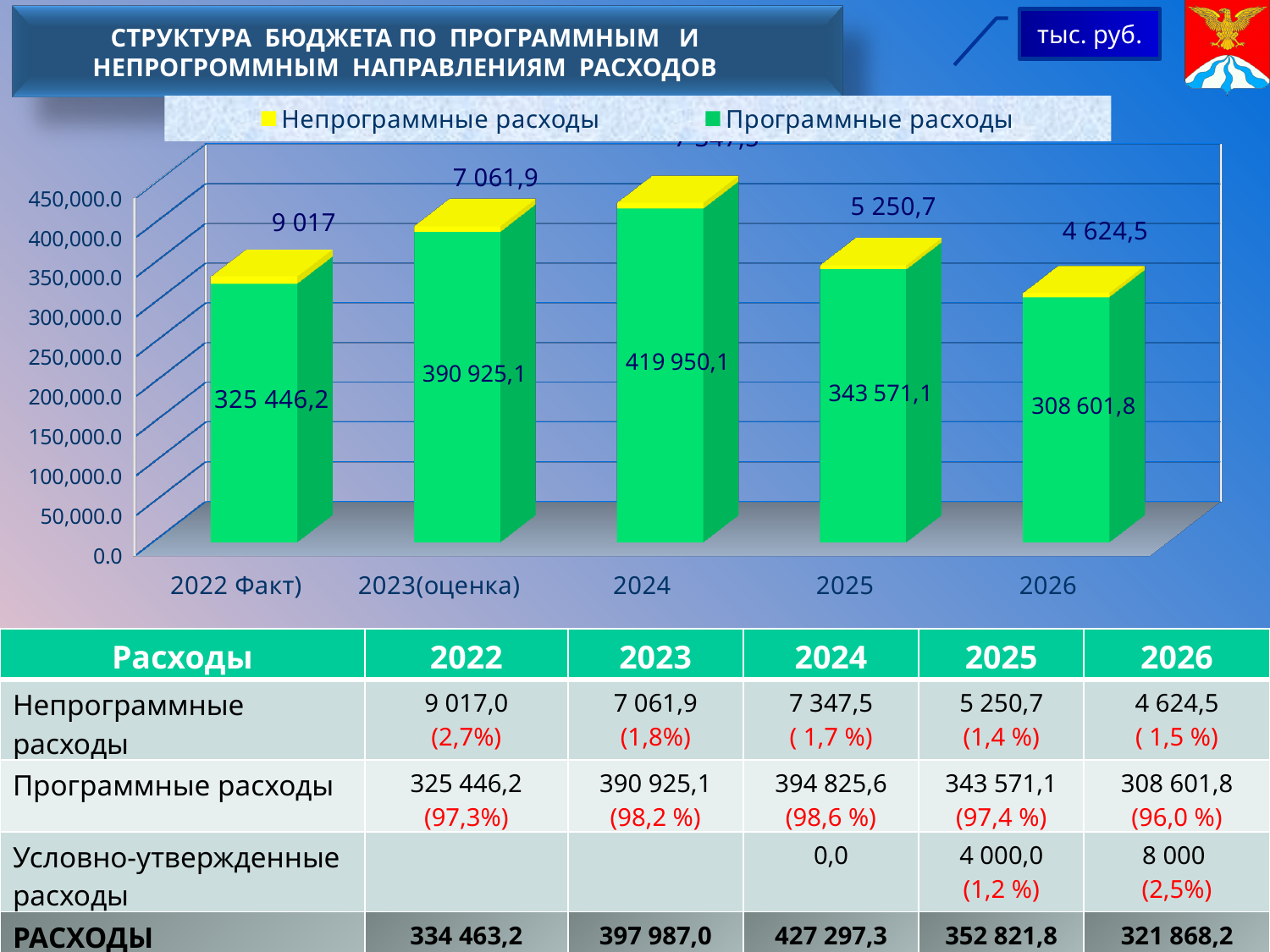
What is the difference between Программные расходы in 2023(оценка) and 2022 Факт)? 65 478,9 What is the total of the stacked bar for 2022 Факт)? 334 463,2 Which category has the highest value for Программные расходы? 2024 What is the value of Программные расходы for 2024? 419 950,1 Which category has the lowest value for Непрограммные расходы? 2026 How many series does the chart legend list? 2 How many categories are shown on the x axis of the chart? 5 What kind of chart is shown on the slide? stacked bar chart What is the value of Непрограммные расходы for 2022 Факт)? 9 017 Is the value of Программные расходы for 2022 Факт) greater or less than 300,000.0? greater Which is larger: Программные расходы in 2025 or in 2026? 2025 What is the value of Программные расходы for 2026? 308 601,8